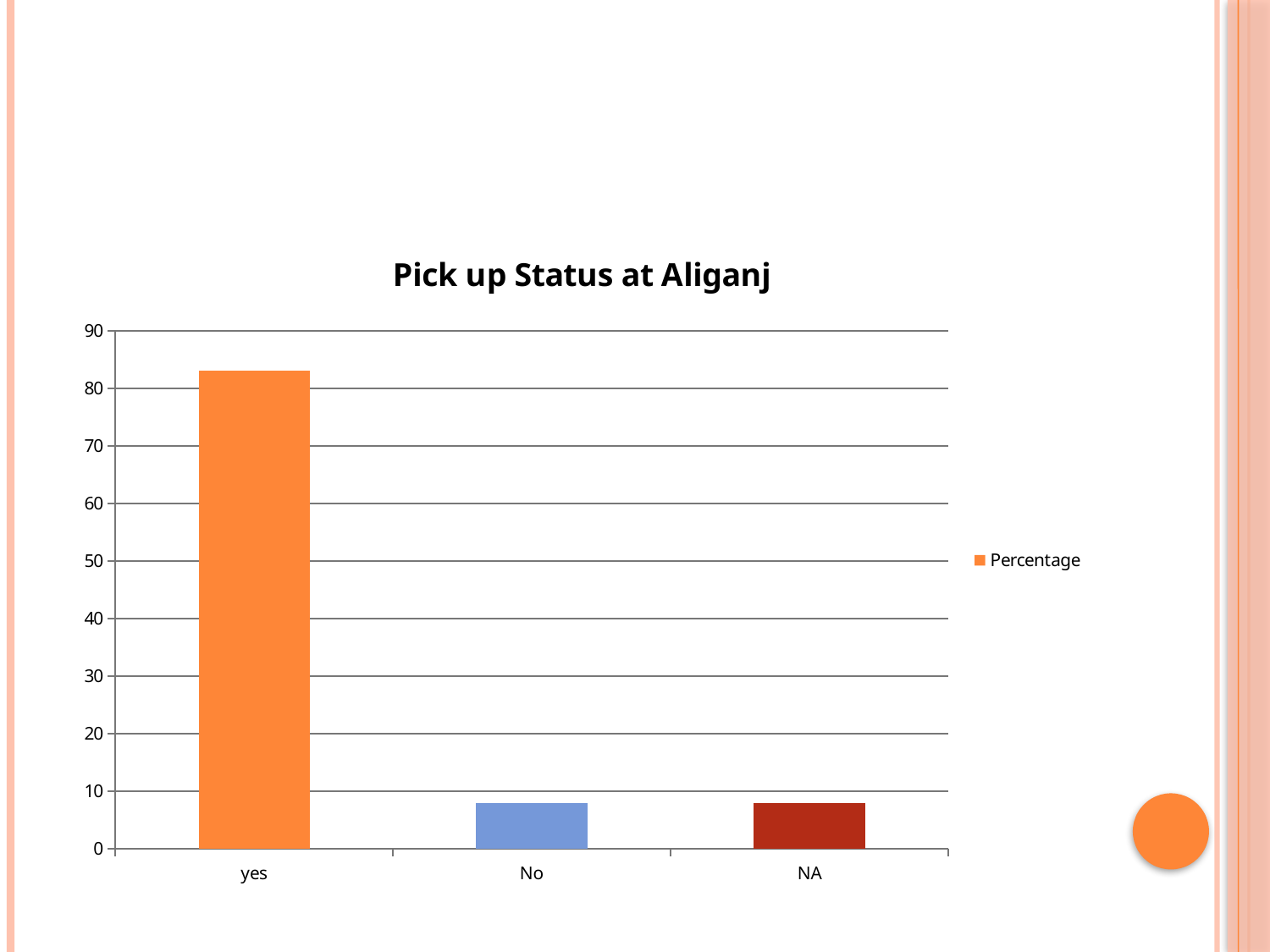
How many series does the legend list? 1 What is the title of the chart? Pick up Status at Aliganj Which is larger, the value for yes or the value for No? yes How many categories are shown on the x axis of the chart? 3 Is the value for NA greater or less than 10? less Which is larger, the value for yes or the value for NA? yes Is the value for yes greater or less than 80? greater What kind of chart is shown on the slide? bar chart What series name is shown in the legend? Percentage Is the value for No greater or less than 10? less Which category has the highest value? yes